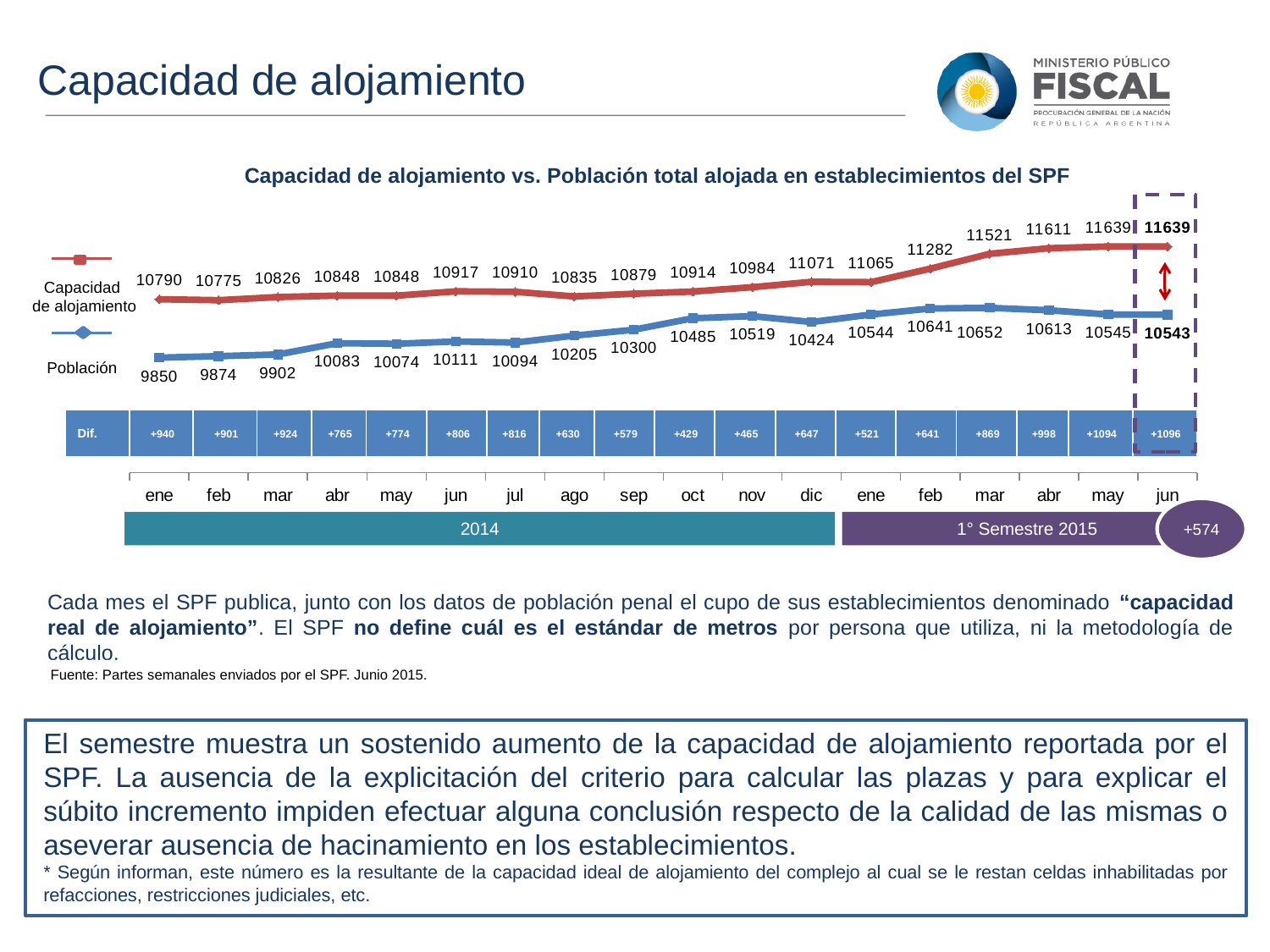
How many series does the chart's legend list? 2 What is the lowest value of Capacidad de alojamiento shown on the chart? 10775 In which month is Población at its highest value? mar 2015 In which month is Población at its lowest value? ene 2014 How many months are plotted on the x axis? 18 What is the value of Población for jun 2015? 10543 Does Capacidad de alojamiento rise or fall from ene 2015 to may 2015? rise What is the value of Capacidad de alojamiento for ene 2014? 10790 What is the value of Capacidad de alojamiento for mar 2015? 11521 What type of chart is shown on the slide? line chart What is the difference between Capacidad de alojamiento and Población in jun 2015? 1096 Which is larger in dic 2014: Capacidad de alojamiento or Población? Capacidad de alojamiento